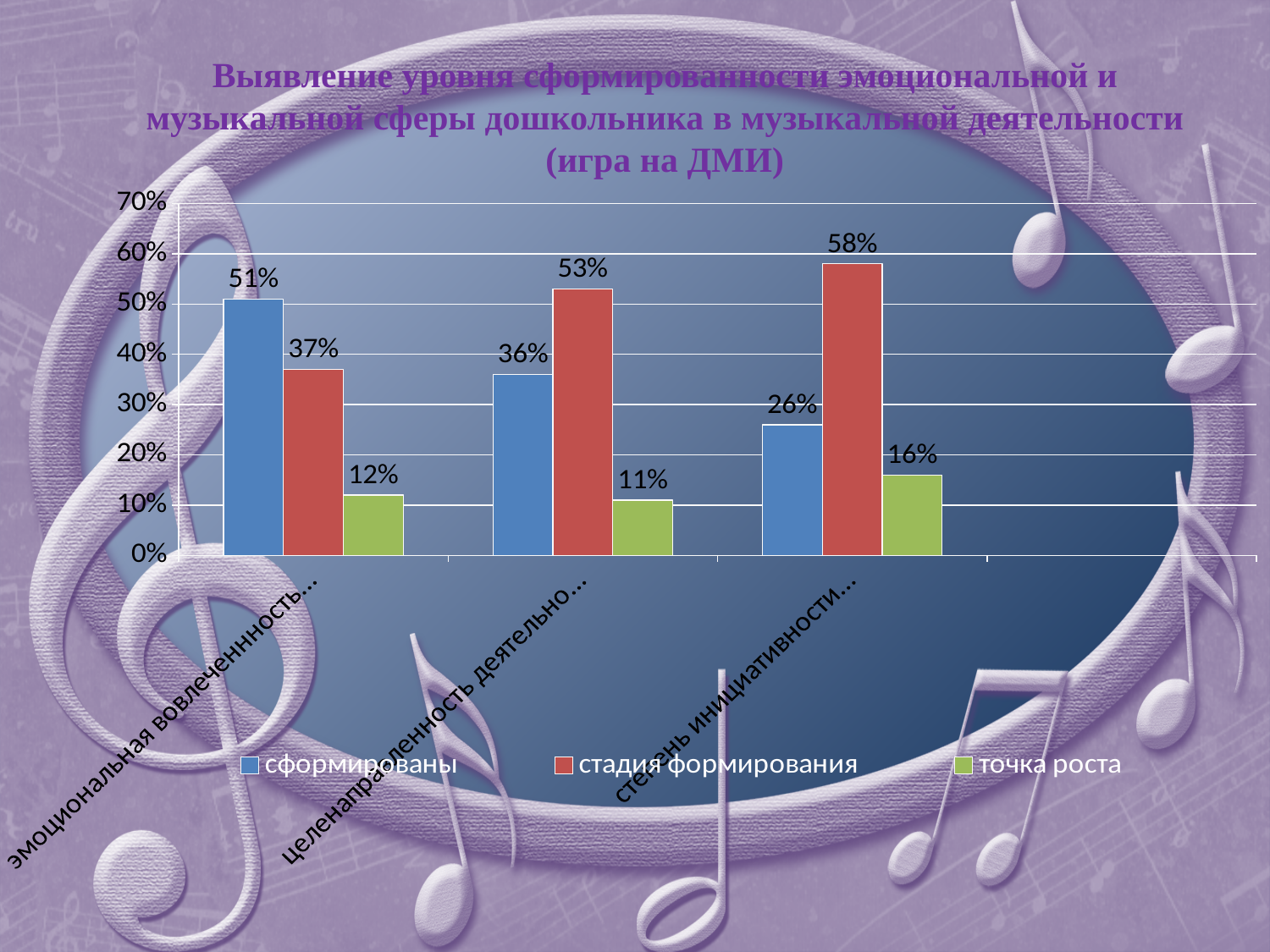
Is the 'стадия формирования' value for the first category (эмоциональная вовлеченность) greater or less than 40%? less How many categories are shown on the x axis? 3 How many series does the legend list? 3 Which colour represents the 'точка роста' series in the legend? green What is the value of the 'стадия формирования' series for the third category (степень инициативности)? 58% What is the value of the 'сформированы' series for the first category (эмоциональная вовлеченность)? 51% For the second category (целенаправленность деятельности), which is larger: 'сформированы' or 'стадия формирования'? стадия формирования What is the difference between the 'стадия формирования' and 'сформированы' values for the third category (степень инициативности)? 32% Which category has the highest value for the 'сформированы' series? эмоциональная вовлеченность Which category has the lowest value for the 'точка роста' series? целенаправленность деятельности What kind of chart is shown on the slide? bar chart What is the value of the 'точка роста' series for the second category (целенаправленность деятельности)? 11%